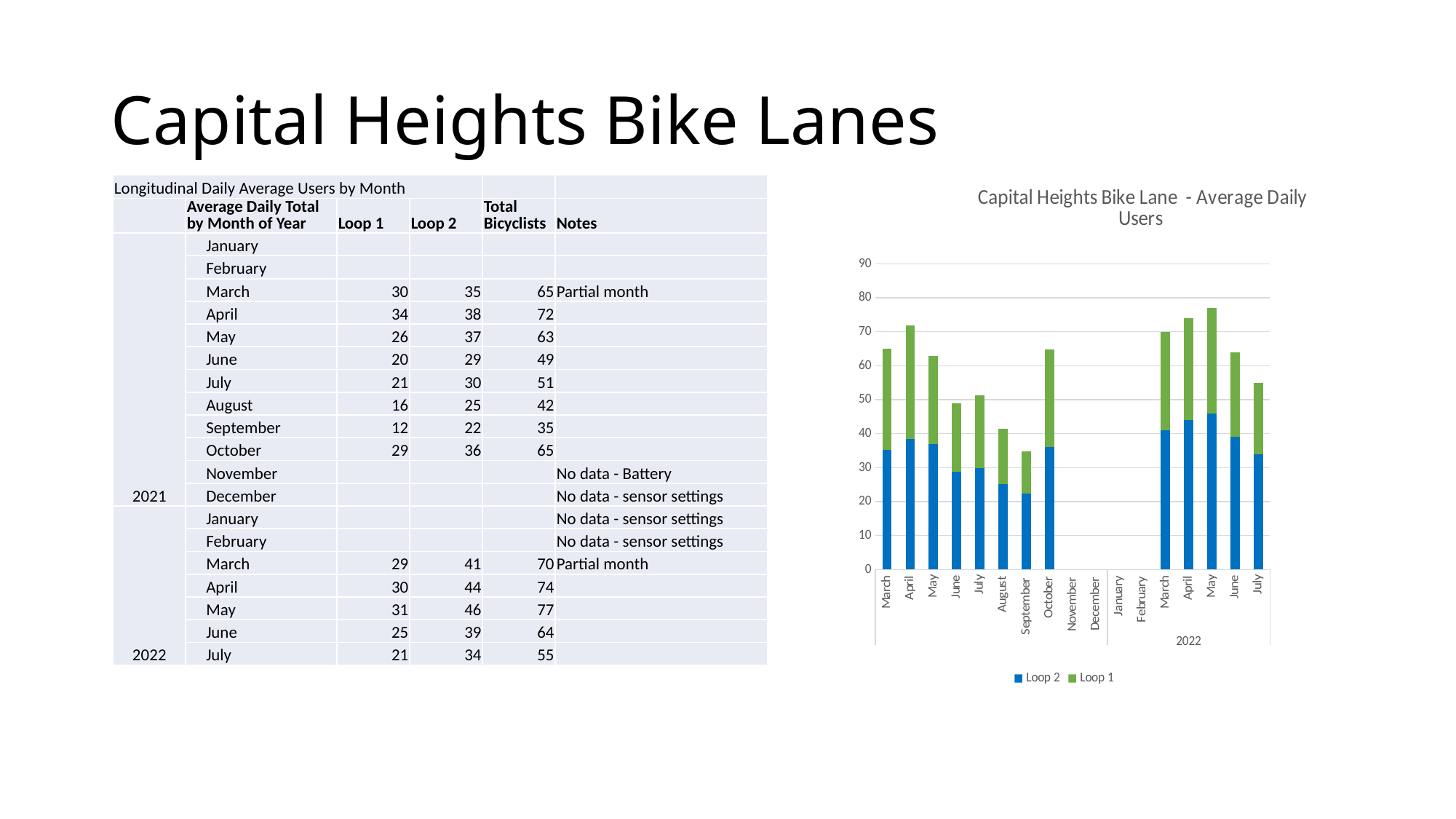
What is the total bicyclists value for May 2022 shown in the table? 77 What kind of chart is shown on the slide? stacked bar chart Is the total bar for April 2022 greater or less than 70? greater Which two series are listed in the chart legend? Loop 2 and Loop 1 Is the stacked bar for October 2021 taller or shorter than the bar for June 2021? taller How many series does the chart legend list? 2 What is the title of the chart? Capital Heights Bike Lane - Average Daily Users Do the stacked bars rise or fall from March 2022 to July 2022 after peaking in May? fall What is the Loop 2 value for April 2021 shown in the table? 38 Which month has the tallest stacked bar in the chart? May 2022 Is the total bar for August 2021 greater or less than 50? less Among the months with bars, which has the shortest stacked bar? September 2021